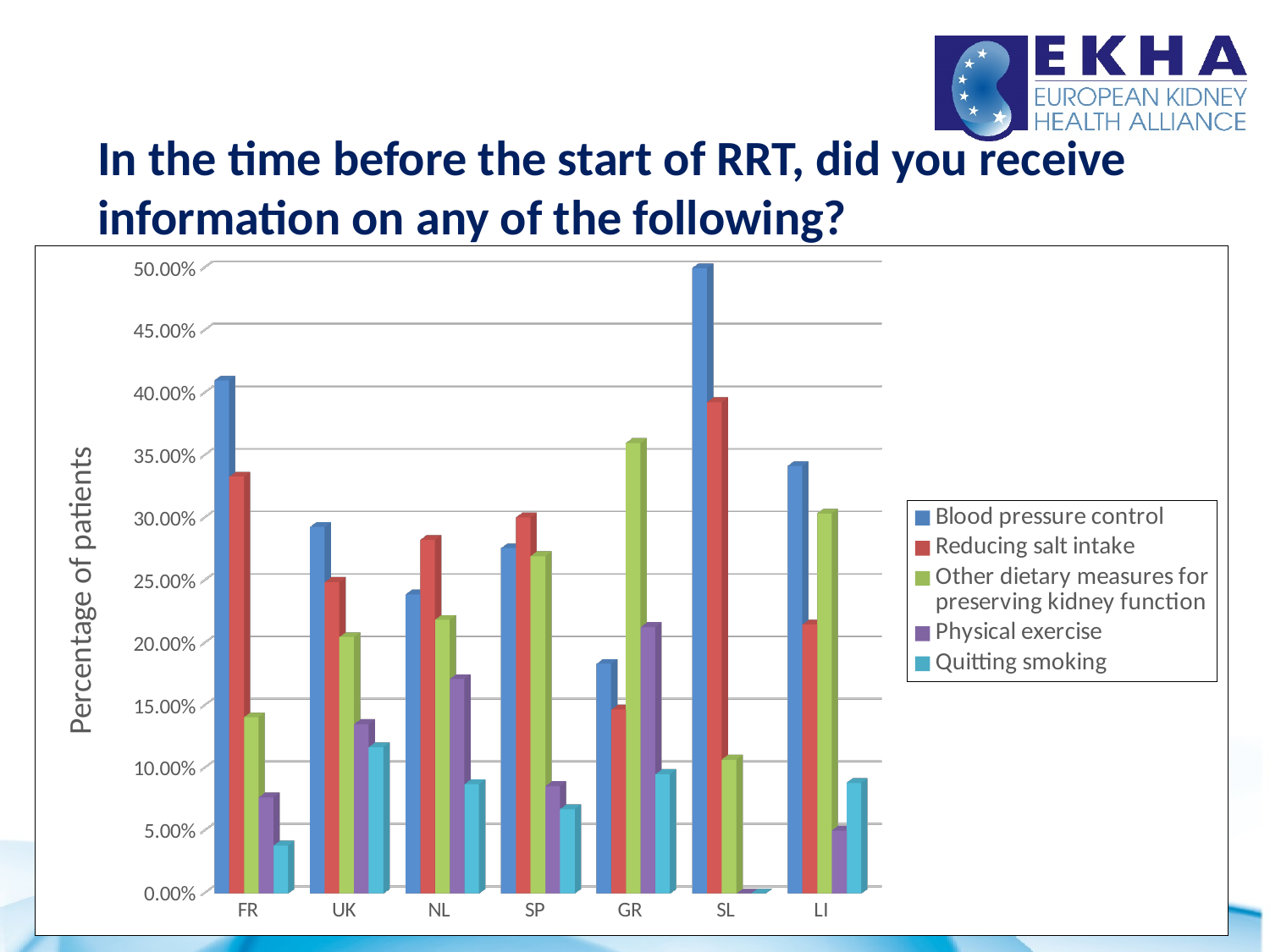
Which country has the lowest value for Quitting smoking? SL How many series does the chart's legend list? 5 What kind of chart is shown on the slide? bar chart Which country has the highest value for Quitting smoking? UK Is the value for Blood pressure control in FR greater or less than 40.00%? greater Is the value for Quitting smoking in FR greater or less than 5.00%? less Which country has the lowest value for Blood pressure control? GR In GR, which is larger: the value for Blood pressure control or the value for Other dietary measures for preserving kidney function? Other dietary measures for preserving kidney function Is the value for Other dietary measures for preserving kidney function in GR greater or less than 35.00%? greater What is the label of the vertical axis of the chart? Percentage of patients How many countries (categories) are shown on the x axis of the chart? 7 Which country has the highest value for Blood pressure control? SL